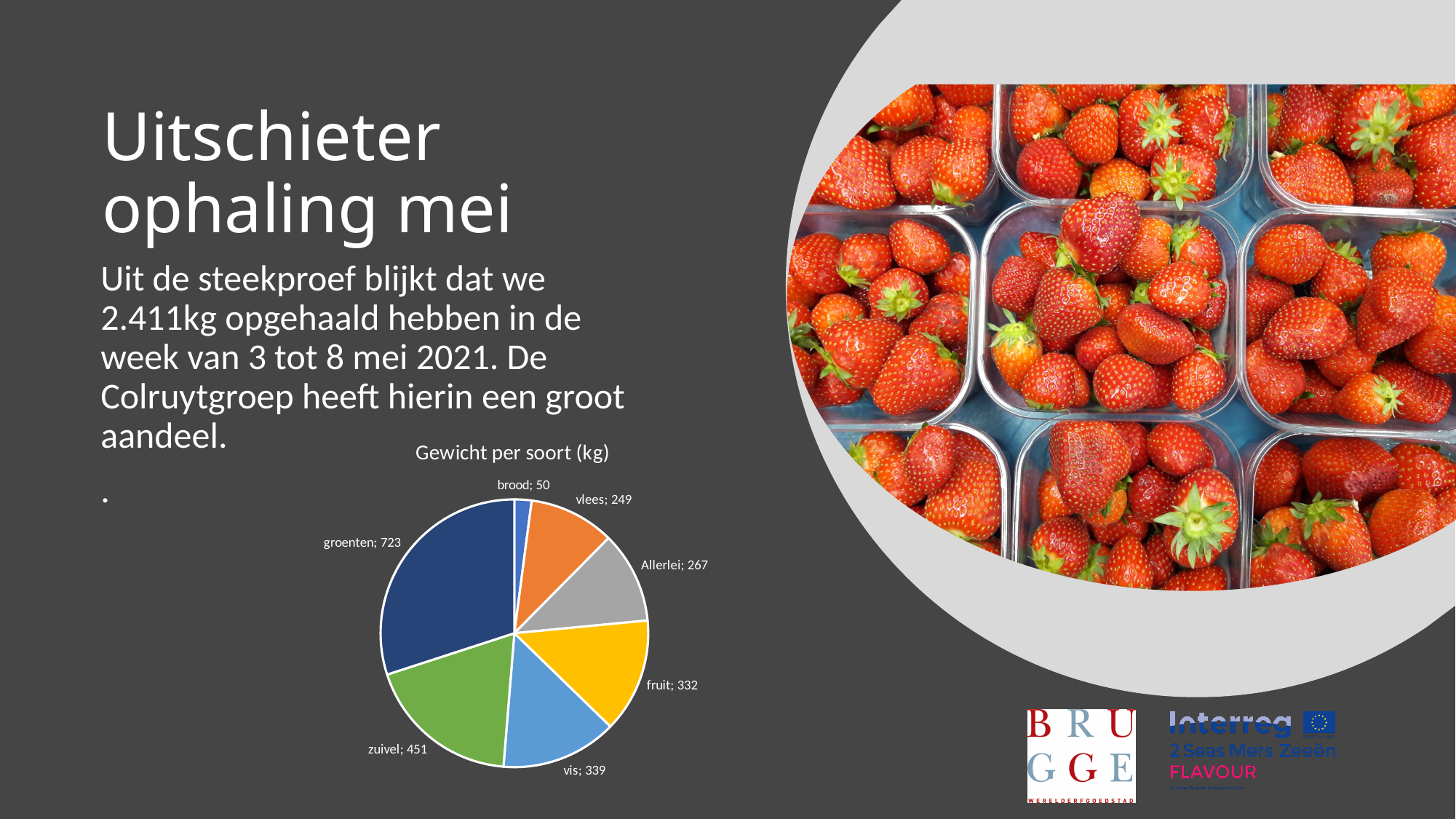
How many categories does the pie chart show? 7 What share of the pie does groenten represent? 30% Which category has the largest slice in the pie chart? groenten What is the difference between the values for groenten and zuivel? 272 Which is larger, the value for vlees or the value for fruit? fruit What is the title of the chart? Gewicht per soort (kg) Which category has the smallest slice in the pie chart? brood What is the value for zuivel in the pie chart? 451 What is the value for brood in the pie chart? 50 What is the value for groenten in the pie chart? 723 What is the total of all slices in the pie chart? 2411 What type of chart is shown on the slide? pie chart